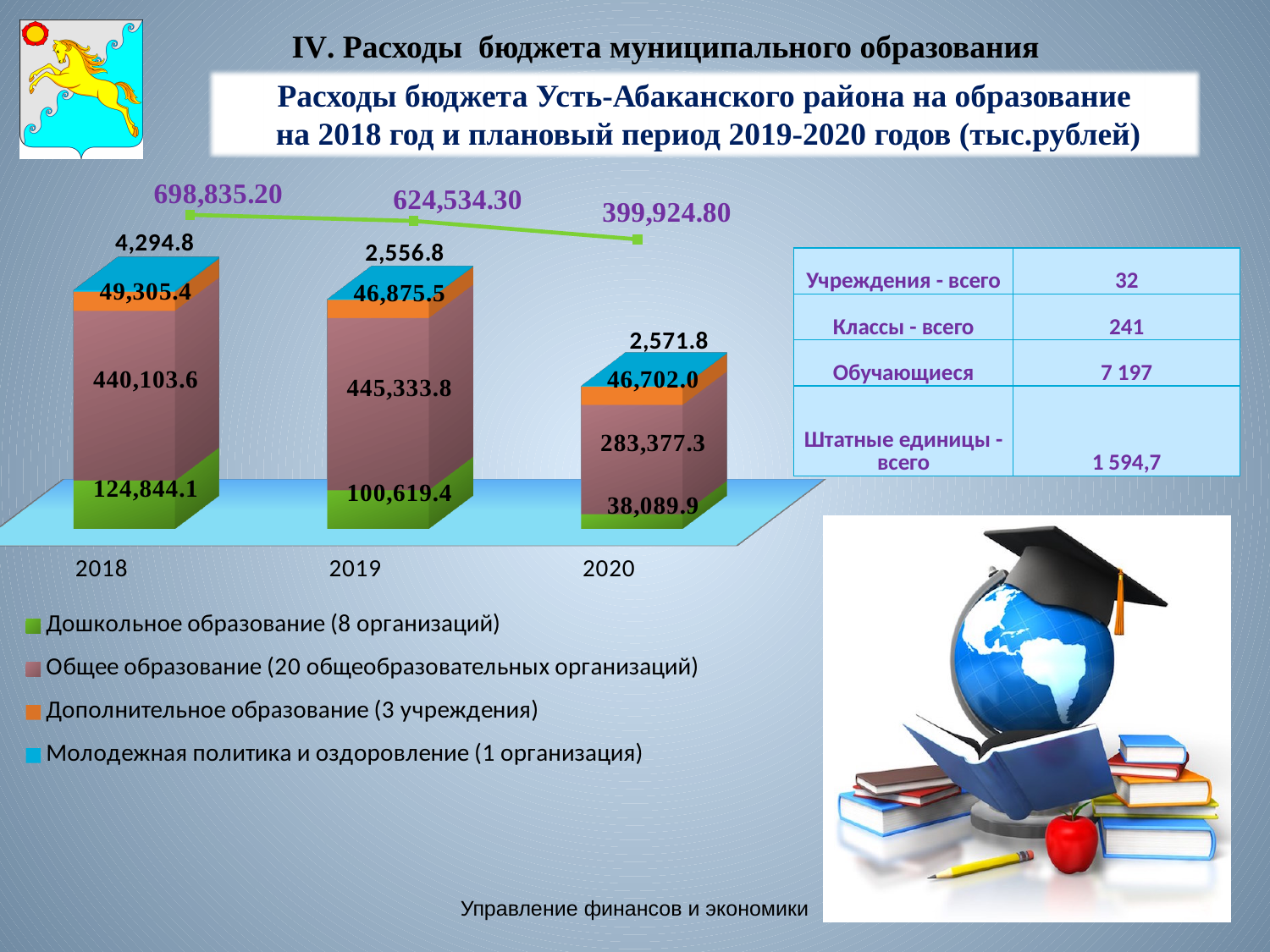
Do the values on the line above the bars rise or fall from 2018 to 2020? Fall In which year is the value for Общее образование the lowest? 2020 What is the value for Общее образование in 2019? 445,333.8 What is the value for Дополнительное образование in 2020? 46,702.0 In which year is the value for Дошкольное образование the highest? 2018 What is the value for Дошкольное образование in 2020? 38,089.9 What is the difference between the Дошкольное образование values for 2018 and 2020? 86,754.2 How many years (categories) are shown on the x axis of the chart? 3 What is the value shown on the line above the bars for 2018? 698,835.20 How many series does the chart legend list? 4 Which is larger: the Дополнительное образование value for 2018 or for 2019? 2018 What kind of chart is shown on the slide? Stacked bar chart with a line